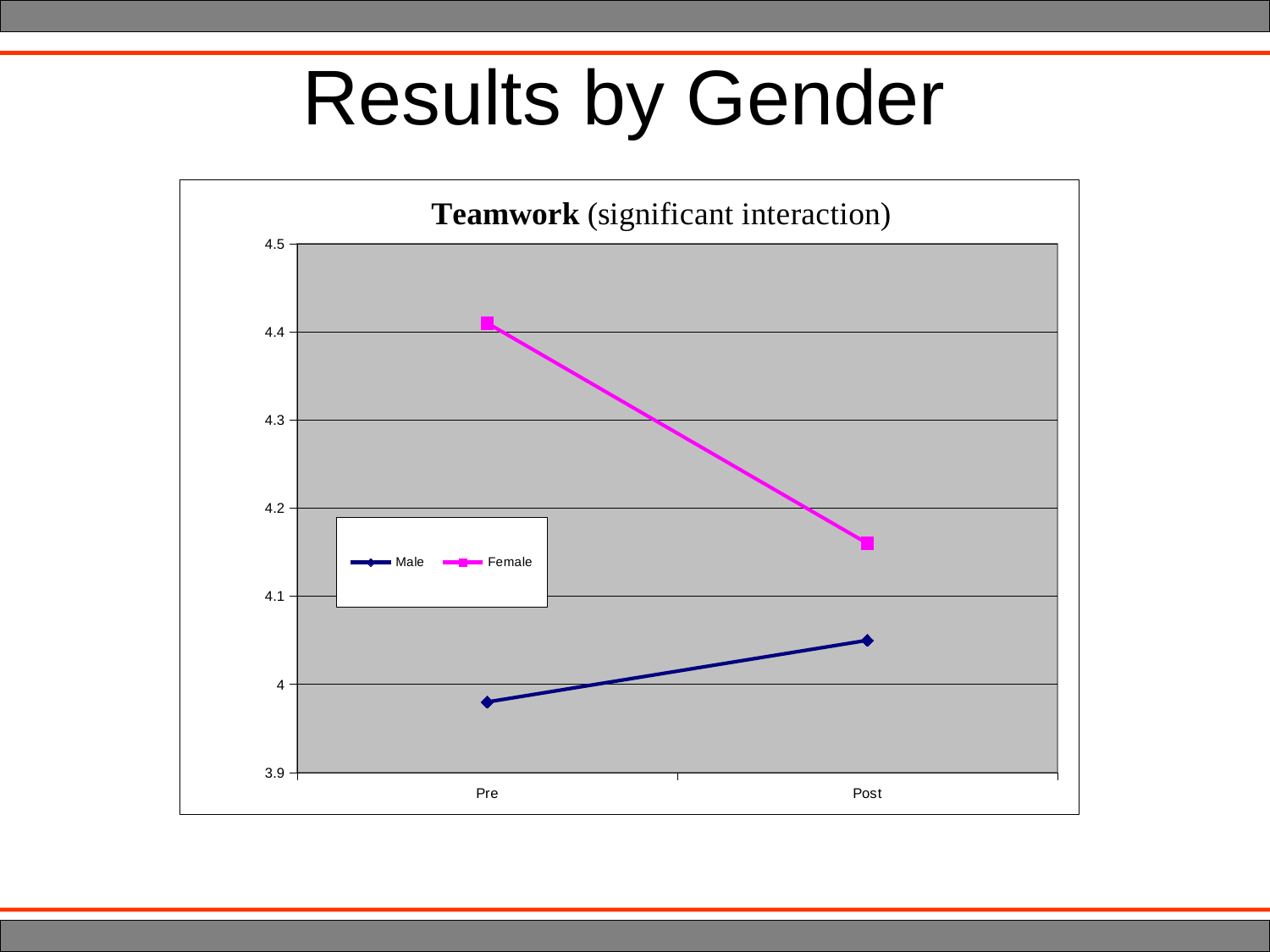
At Post, which series has the higher value, Male or Female? Female How many series does the legend list? 2 Which series are listed in the legend? Male and Female Does the Female series rise or fall from Pre to Post? fall Is the Male value at Post greater or less than 4.1? less Does the Male series rise or fall from Pre to Post? rise Is the Female value at Post greater or less than 4.2? less What kind of chart is shown on the slide? line chart Is the Male value at Pre greater or less than 4.1? less What is the title of the chart? Teamwork (significant interaction) How many categories are shown on the x axis? 2